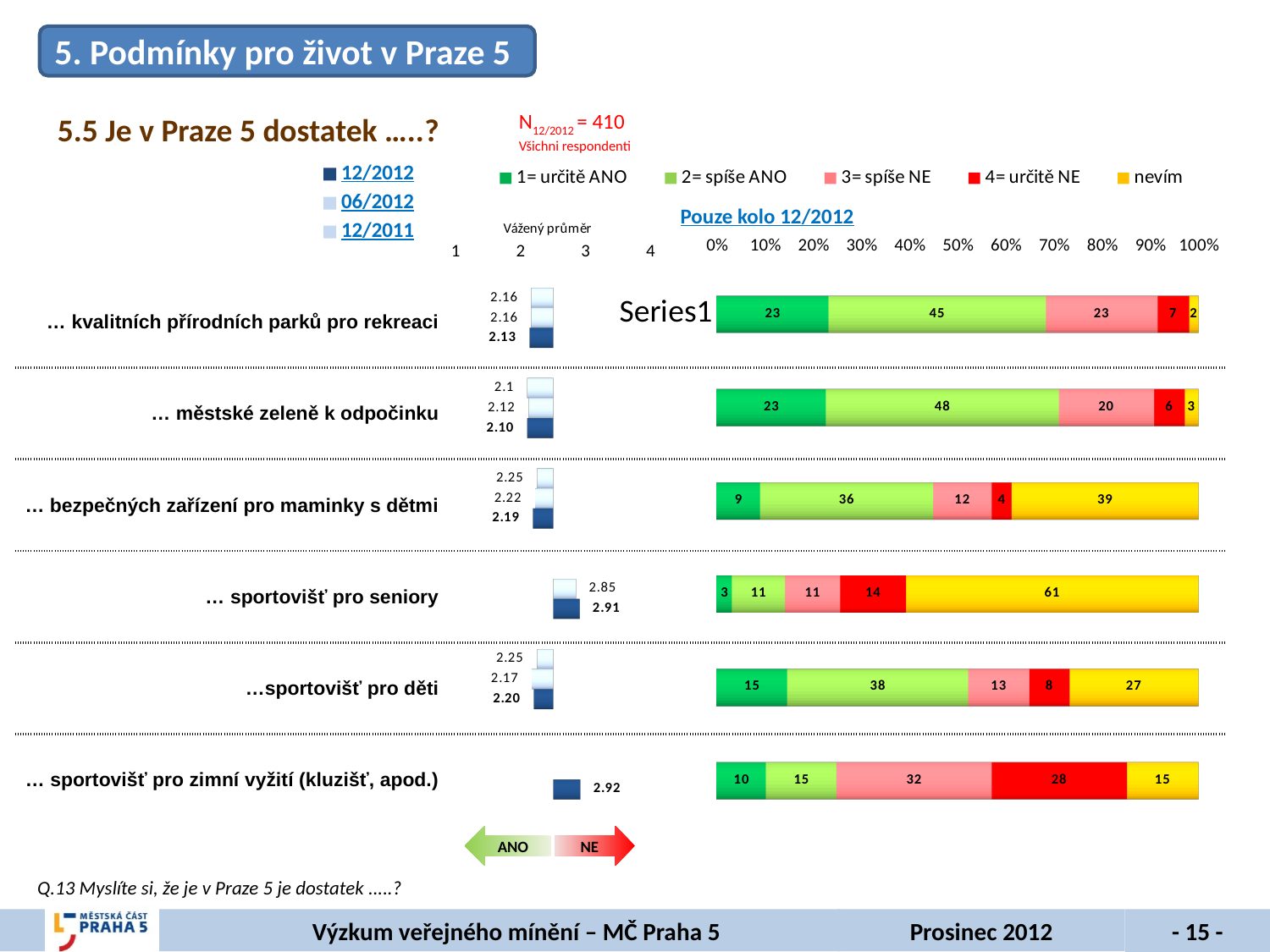
What kind of chart is the "Pouze kolo 12/2012" chart on the right? Stacked bar chart In the weighted average chart (Vážený průměr), which category has the lowest 12/2012 value? … městské zeleně k odpočinku In the weighted average chart (Vážený průměr), what is the 12/2011 value for "… kvalitních přírodních parků pro rekreaci"? 2.16 In the weighted average chart (Vážený průměr), what is the 12/2012 value for "… sportovišť pro zimní vyžití (kluzišť, apod.)"? 2.92 In the stacked bar chart (Pouze kolo 12/2012), what is the "nevím" value for "… sportovišť pro seniory"? 61 In the stacked bar chart (Pouze kolo 12/2012), what percentage of respondents answered "2= spíše ANO" for "… městské zeleně k odpočinku"? 48 In the stacked bar chart (Pouze kolo 12/2012), what is the difference between the "1= určitě ANO" value for "… kvalitních přírodních parků pro rekreaci" and for "… sportovišť pro seniory"? 20 How many categories (rows) are shown in the stacked bar chart (Pouze kolo 12/2012)? 6 How many series does the legend of the stacked bar chart (Pouze kolo 12/2012) list? 5 In the stacked bar chart (Pouze kolo 12/2012), which category has the highest "4= určitě NE" value? … sportovišť pro zimní vyžití (kluzišť, apod.) In the stacked bar chart (Pouze kolo 12/2012), which category has the highest "nevím" share? … sportovišť pro seniory In the stacked bar chart (Pouze kolo 12/2012), which has the larger "3= spíše NE" value: "… sportovišť pro zimní vyžití (kluzišť, apod.)" or "…sportovišť pro děti"? … sportovišť pro zimní vyžití (kluzišť, apod.)